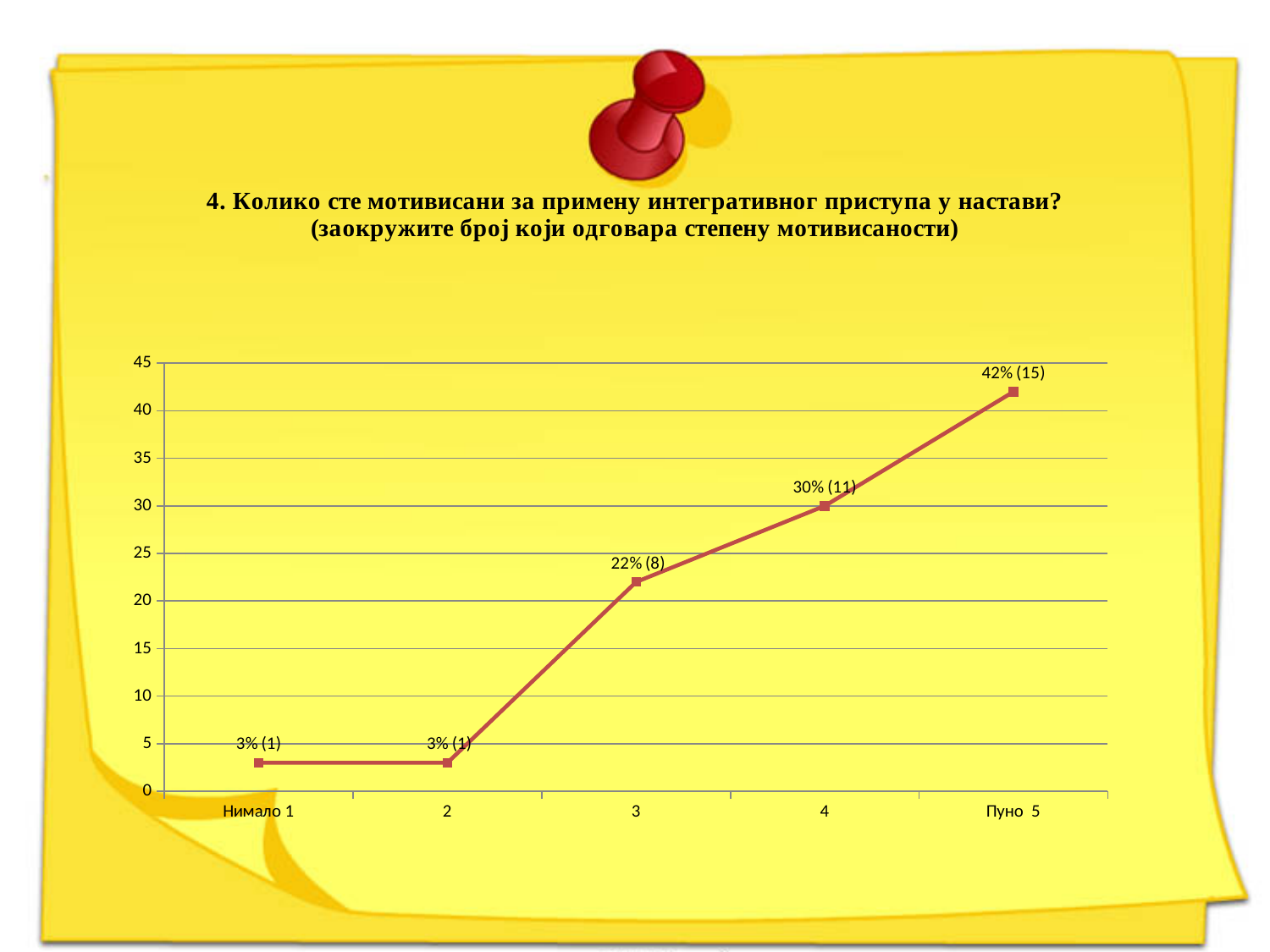
What is the data label for category 4? 30% (11) What is the data label for 'Пуно 5'? 42% (15) Do the values rise or fall from 'Нимало 1' to 'Пуно 5' along the x axis? rise What is the data label for category 3? 22% (8) What is the difference in percentage points between category 4 and category 3? 8 How many categories are plotted on the x axis? 5 What is the highest value shown on the y axis? 45 What is the data label for 'Нимало 1'? 3% (1) What kind of chart is shown on the slide? line chart Which is larger, the value for category 3 or the value for category 4? category 4 What is the difference in percentage points between 'Пуно 5' and category 4? 12 Which category has the highest value? Пуно 5